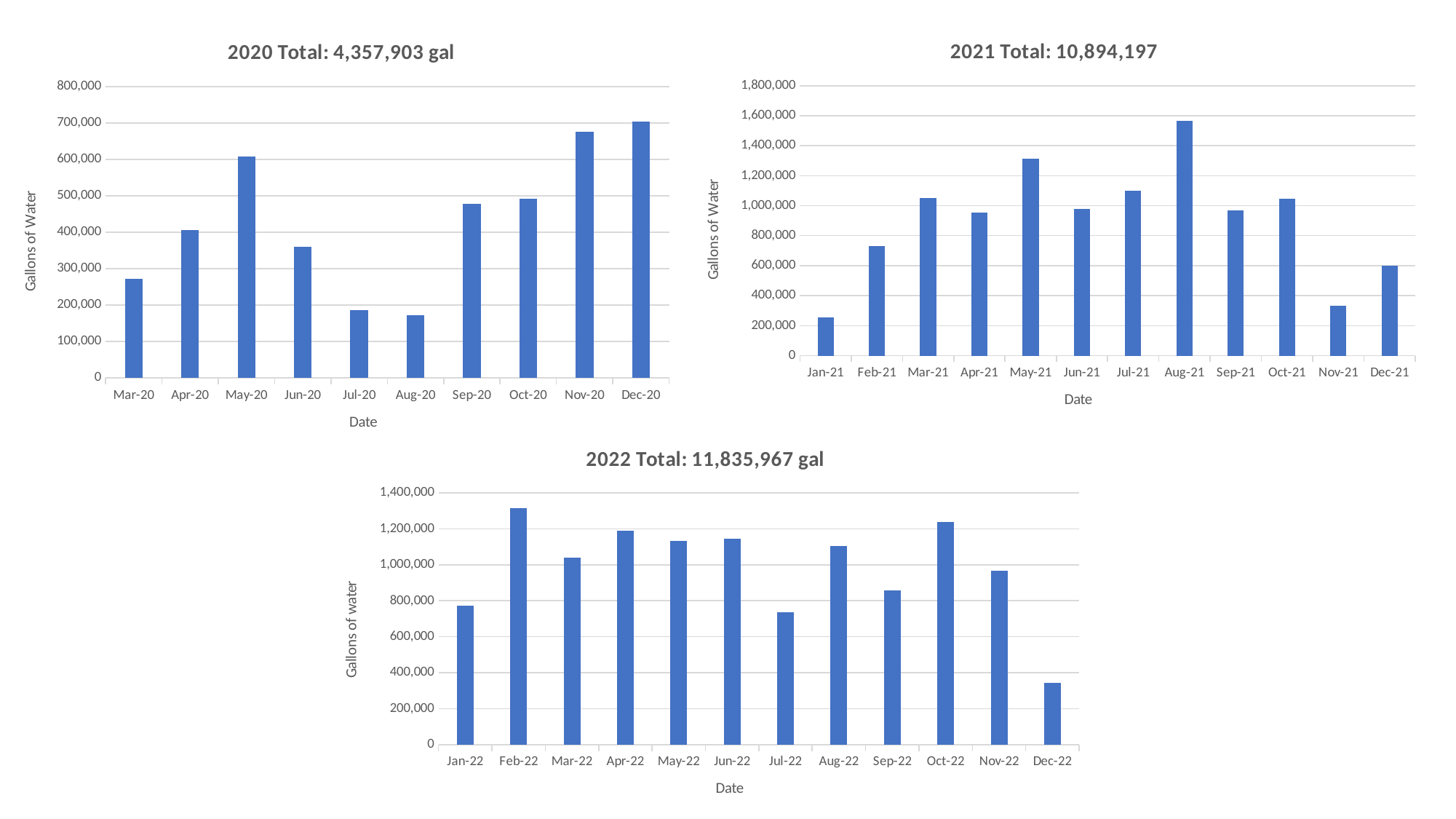
What total is stated in the title of the 2021 chart? 10,894,197 In the 2021 Total chart, which month has the lowest value? Jan-21 In the 2022 Total chart, is the value for Jul-22 greater or less than 800,000? less In the 2020 Total chart, is the value for Jul-20 greater or less than 200,000? less In the 2021 Total chart, how many months are plotted? 12 In the 2020 Total chart, how many months are plotted on the x axis? 10 In the 2021 Total chart, which month has the highest value? Aug-21 In the 2020 Total chart, which month has the highest value? Dec-20 In the 2022 Total chart, which month has the lowest value? Dec-22 What type of chart is the 2020 Total chart? bar chart In the 2022 Total chart, which month has the highest value? Feb-22 In the 2021 Total chart, is the value for May-21 greater or less than 1,200,000? greater